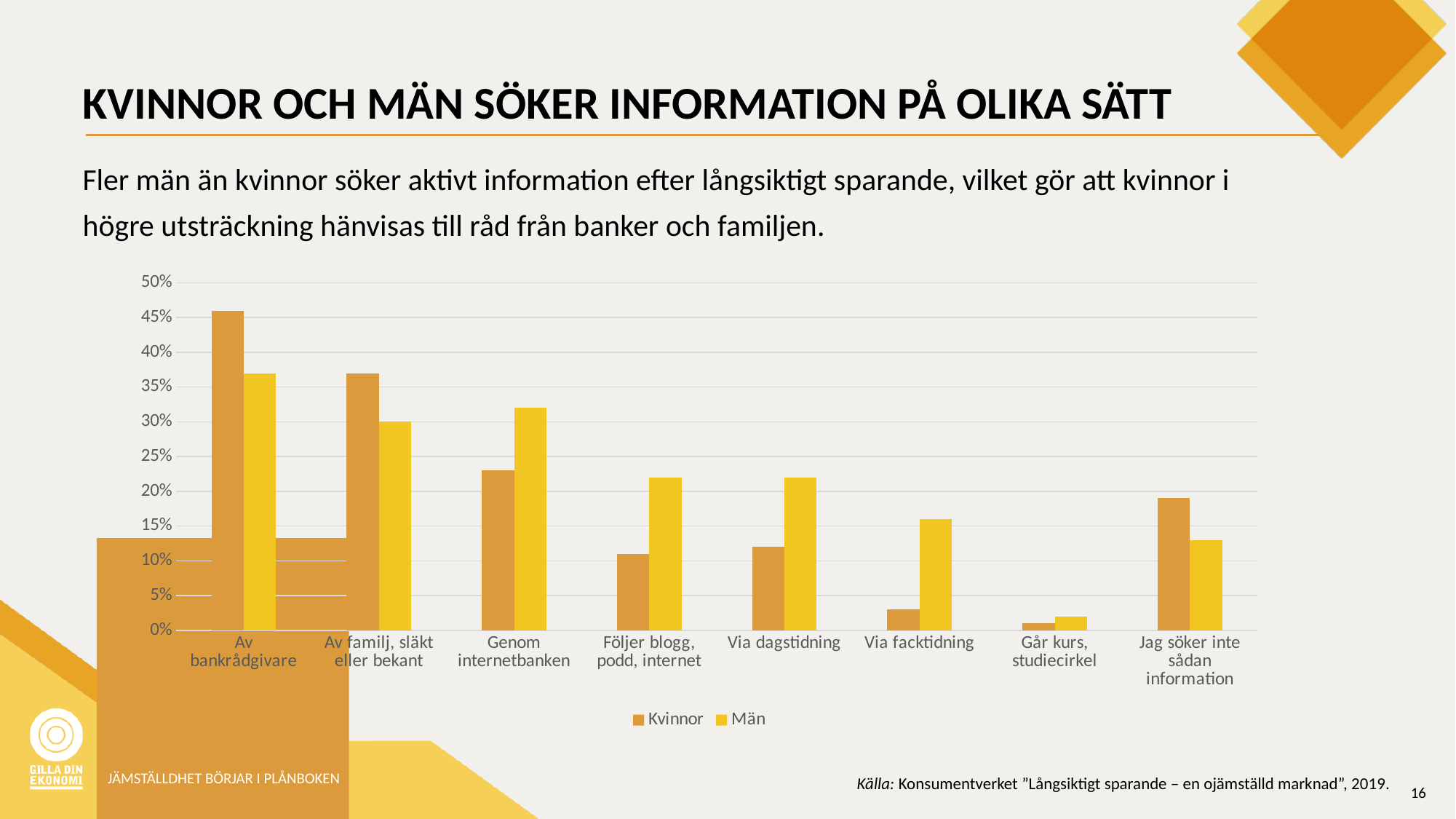
Which category has the highest value for Män? Av bankrådgivare How many categories are shown on the x axis? 8 Which category has the lowest value for Män? Går kurs, studiecirkel What kind of chart is shown on the slide? bar chart Which category has the highest value for Kvinnor? Av bankrådgivare Which category has the lowest value for Kvinnor? Går kurs, studiecirkel For Genom internetbanken, which series has the larger value, Kvinnor or Män? Män Is the value for Kvinnor in Av bankrådgivare greater or less than 40%? greater What are the two series named in the legend? Kvinnor and Män Is the value for Kvinnor in Via facktidning greater or less than 5%? less For Jag söker inte sådan information, which series has the larger value, Kvinnor or Män? Kvinnor How many series does the legend list? 2